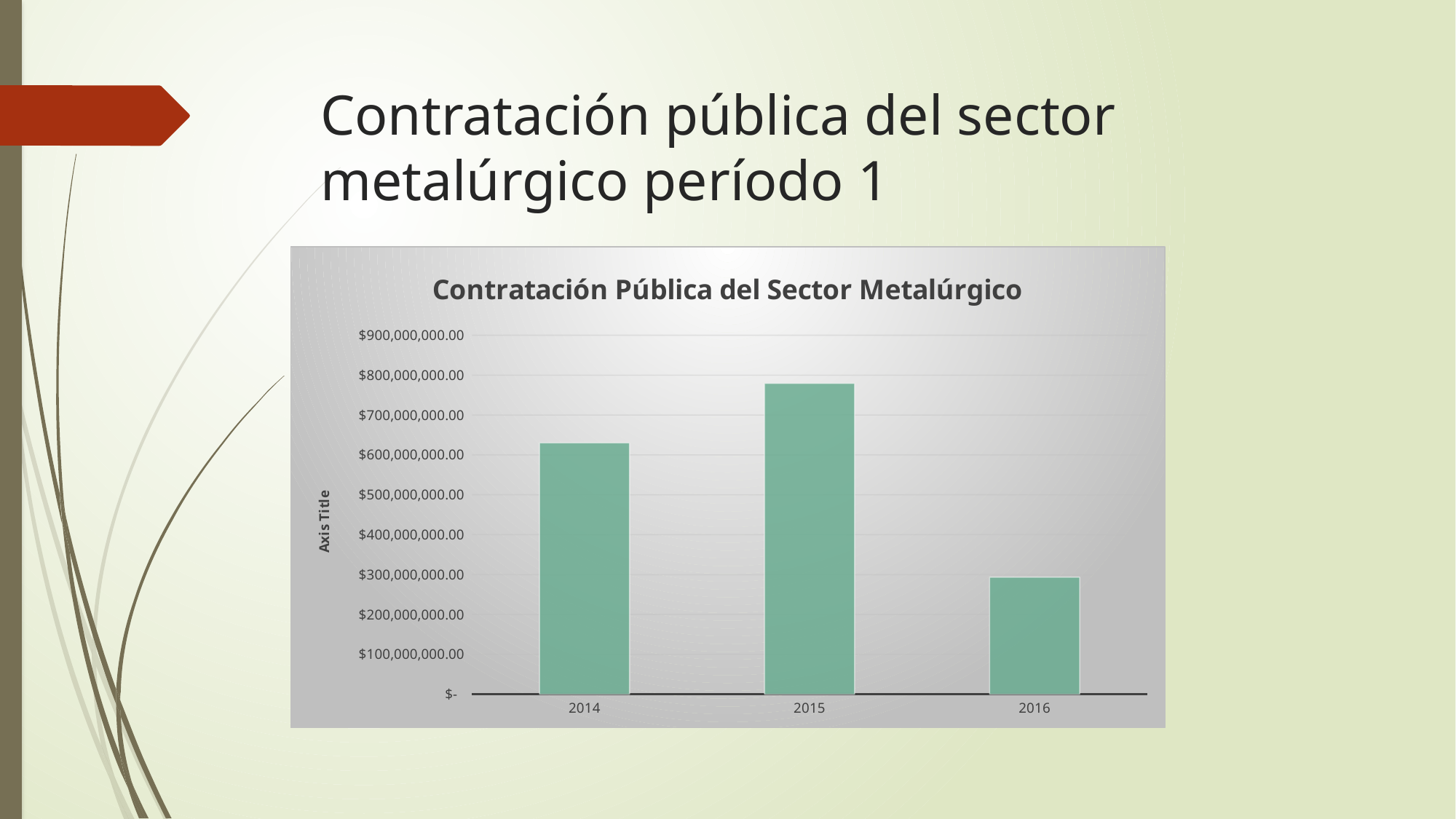
Is the value for 2014 greater or less than $700,000,000.00? less Which year has the larger value, 2014 or 2016? 2014 Which year has the lowest value on the chart? 2016 Is the value for 2014 greater or less than $600,000,000.00? greater What label is shown on the vertical axis of the chart? Axis Title What is the title of the chart? Contratación Pública del Sector Metalúrgico Is the value for 2015 greater or less than $700,000,000.00? greater Do the values rise or fall from 2015 to 2016? fall What kind of chart is shown on the slide? Bar chart How many years (categories) are plotted on the chart? 3 Which year has the highest value on the chart? 2015